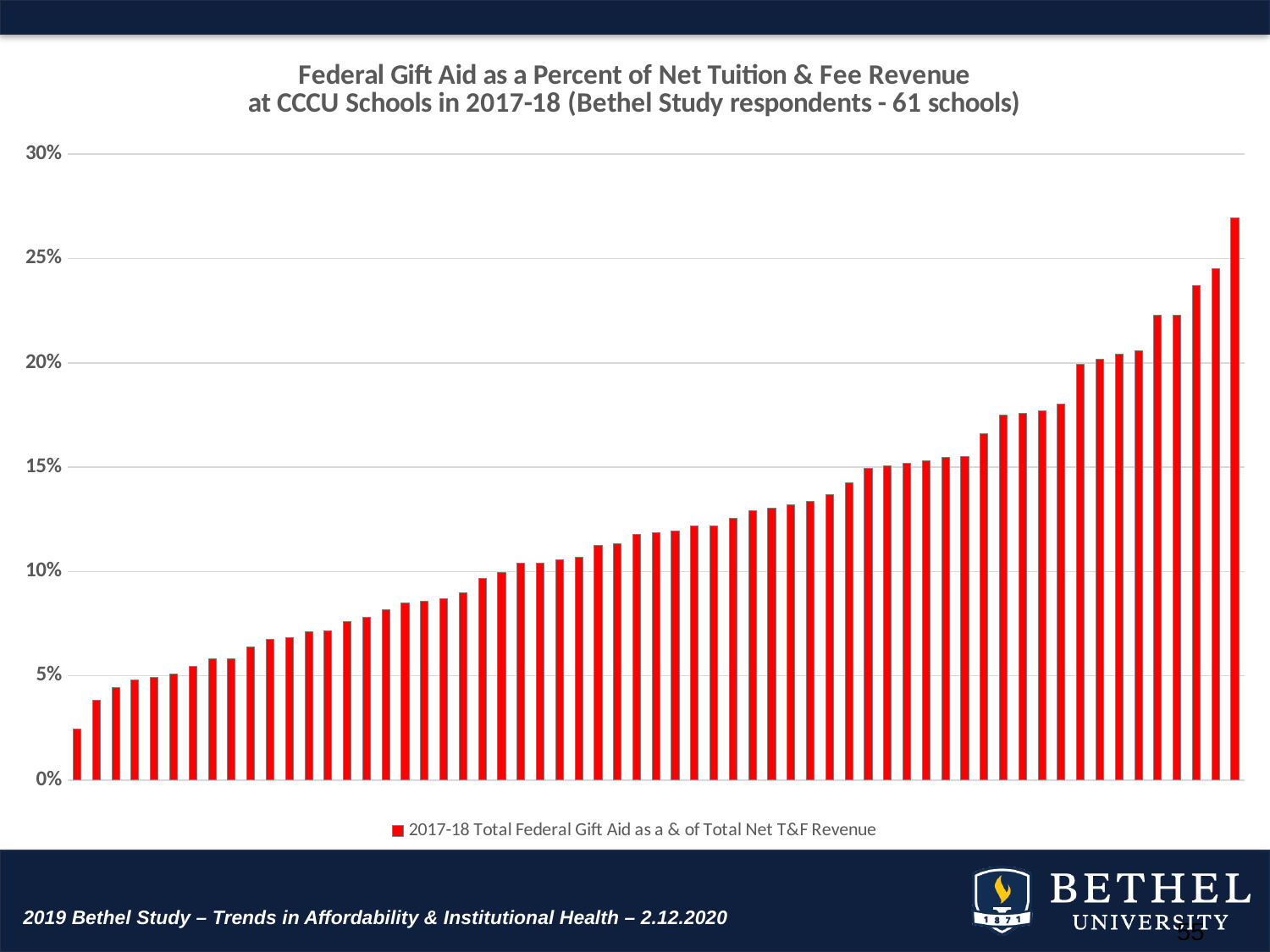
How many series does the legend list? 1 What is the highest value shown on the vertical axis? 30% What is the legend entry for the series plotted in the chart? 2017-18 Total Federal Gift Aid as a & of Total Net T&F Revenue Is the value of the leftmost bar greater or less than 0%? greater What kind of chart is shown on the slide? bar chart Is the value of the tallest bar greater or less than 30%? less Which bar is taller, the leftmost bar or the rightmost bar? the rightmost bar Is the value of the tallest bar (rightmost) greater or less than 25%? greater Do the bar values rise or fall from left to right along the x axis? rise According to the chart title, how many schools are represented in the chart? 61